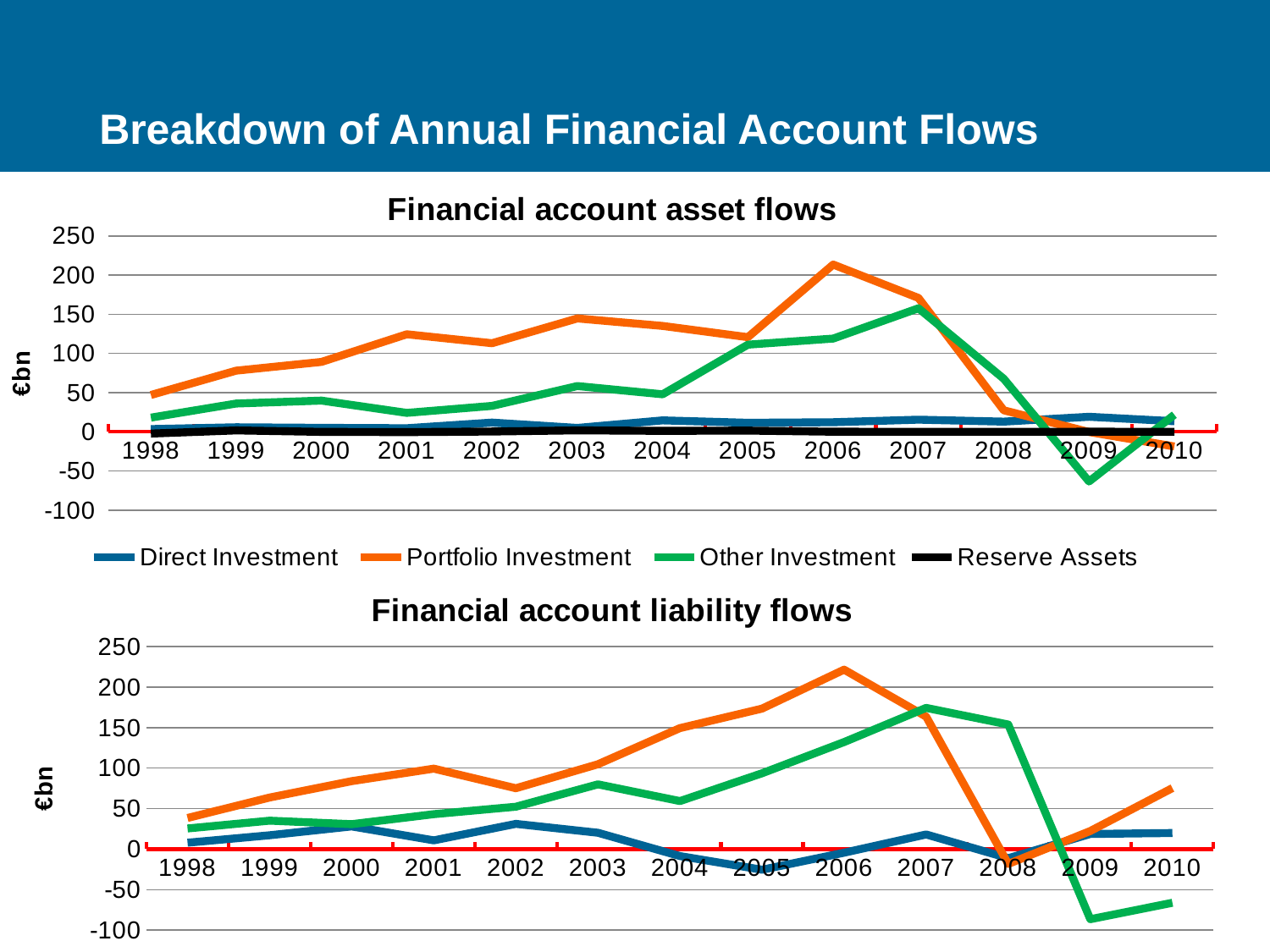
What kind of chart is the 'Financial account asset flows' chart? line chart In the 'Financial account liability flows' chart, is the value of the orange line in 2006 greater or less than 200? greater In the 'Financial account asset flows' chart, in which year does Portfolio Investment reach its highest value? 2006 In the 'Financial account asset flows' chart, in which year does Other Investment reach its lowest value? 2009 In the 'Financial account asset flows' chart, does Portfolio Investment rise or fall from 2006 to 2009? fall How many years are shown on the x axis of the 'Financial account asset flows' chart? 13 In the 'Financial account asset flows' chart, is the value for Portfolio Investment in 2006 greater or less than 200? greater In the 'Financial account asset flows' chart, which is larger in 2003: Portfolio Investment or Other Investment? Portfolio Investment In the 'Financial account liability flows' chart, does the orange line rise or fall from 2008 to 2010? rise In the 'Financial account asset flows' chart, is the value for Other Investment in 2009 greater or less than -50? less How many series does the legend of the 'Financial account asset flows' chart list? 4 What is the y-axis label on the 'Financial account liability flows' chart? €bn